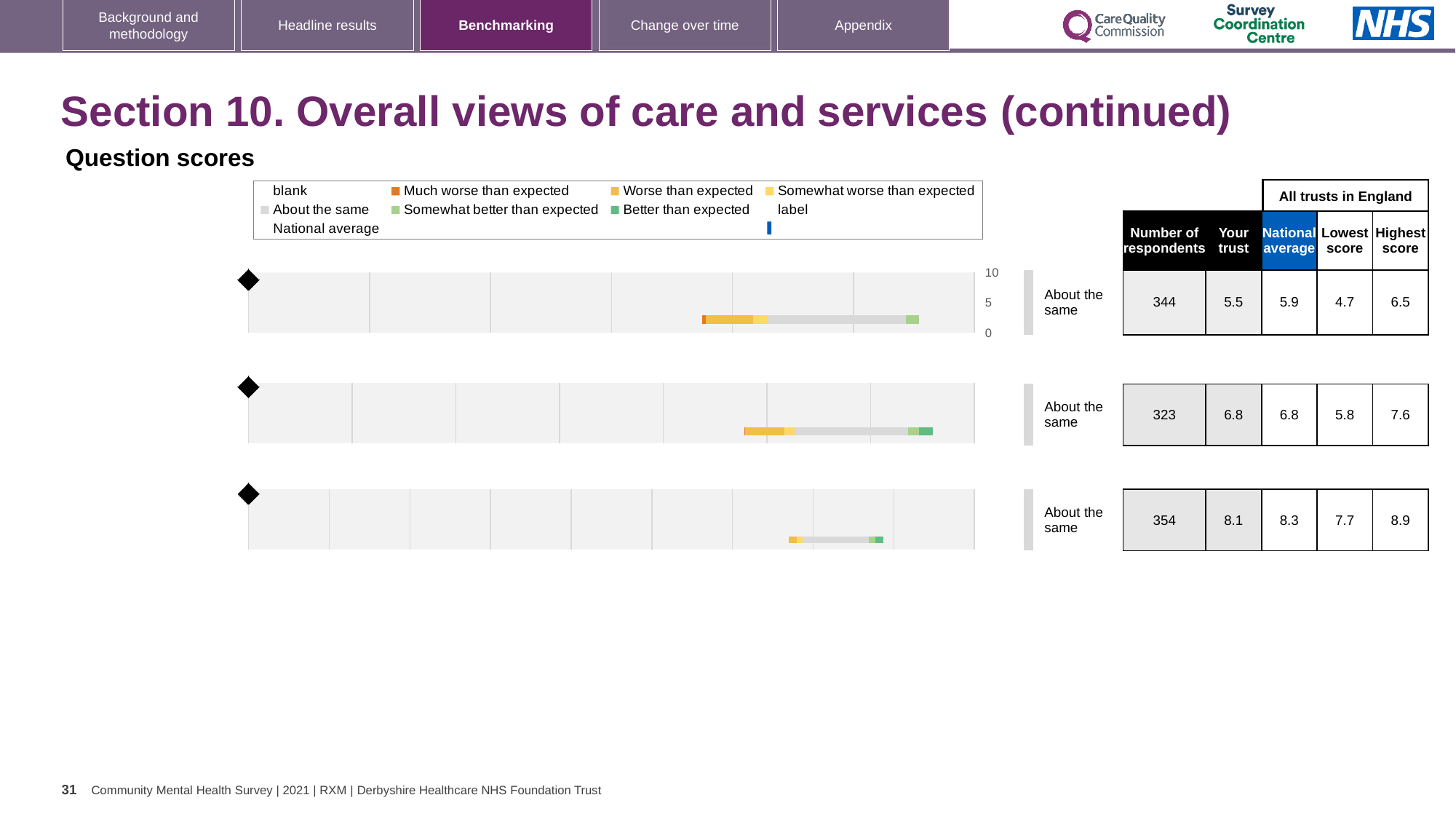
For the top chart, what is the national average score? 5.9 Is the 'Your trust' score for the top chart greater or less than 5? greater What kind of chart is used to show the question scores on this slide? bar chart For the top chart, what is the 'Your trust' score shown in the table? 5.5 What is the maximum value shown on the score axis of the top chart? 10 For the bottom chart, what is the highest score among all trusts in England? 8.9 How many question score charts are shown on the slide? 3 For the middle chart, how many respondents are listed? 323 For the bottom chart, what is the difference between the highest score and the lowest score? 1.2 For the top chart, what is the difference between the highest score and the lowest score? 1.8 For the bottom chart, which is larger: the 'Your trust' score or the national average? National average Which of the three charts has the highest 'Your trust' score? the bottom chart